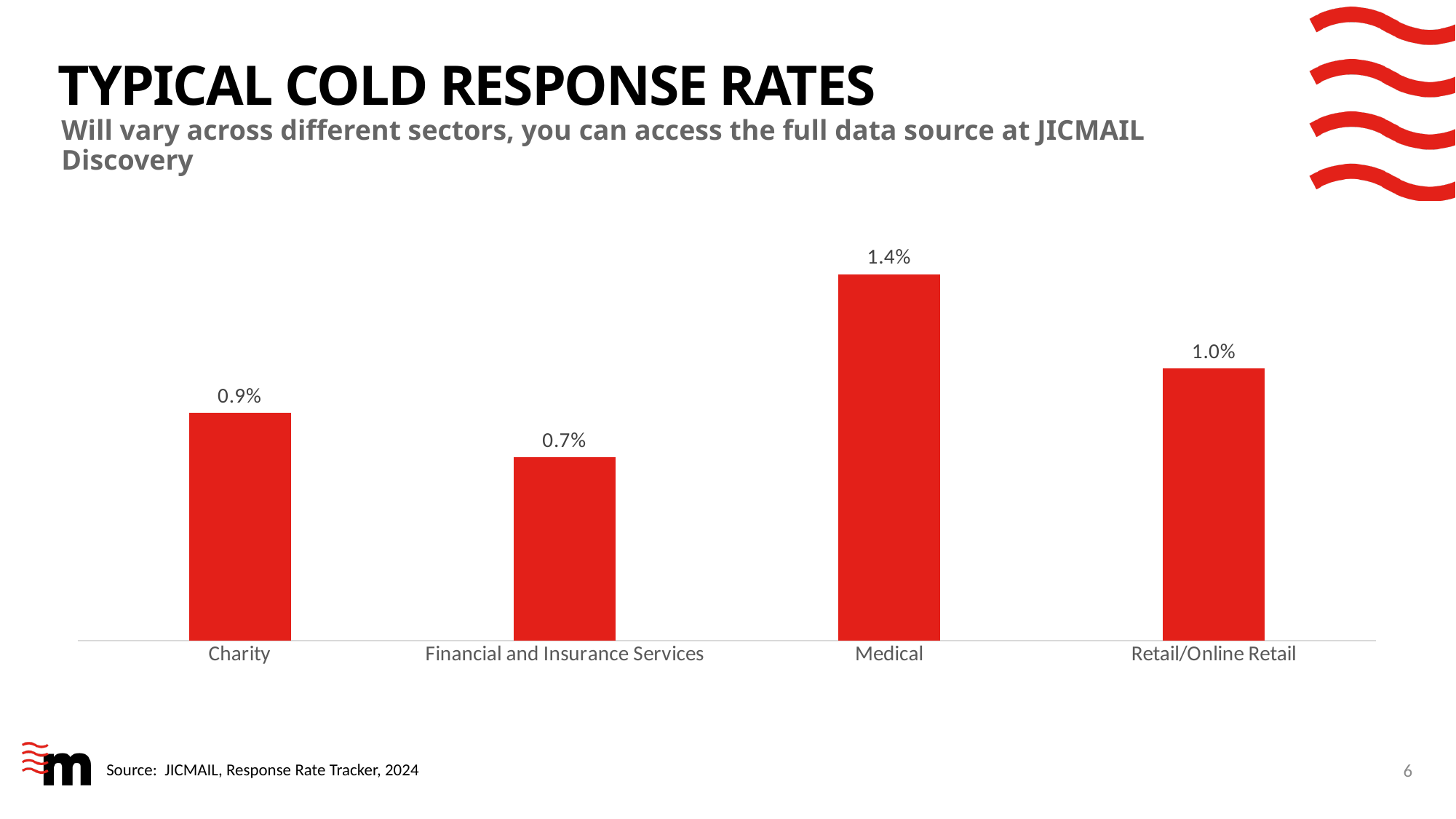
What is the difference between the cold response rates for Medical and Financial and Insurance Services? 0.7% Which has a higher cold response rate, Charity or Retail/Online Retail? Retail/Online Retail What is the difference between the cold response rates for Retail/Online Retail and Charity? 0.1% Which sector has the highest cold response rate? Medical What is the cold response rate for Retail/Online Retail? 1.0% What is the cold response rate for Charity? 0.9% What kind of chart is shown on the slide? Bar chart What is the cold response rate for Medical? 1.4% What is the cold response rate for Financial and Insurance Services? 0.7% Which sector has the lowest cold response rate? Financial and Insurance Services How many sectors are shown in the chart? 4 What is the title of the slide containing the chart? TYPICAL COLD RESPONSE RATES